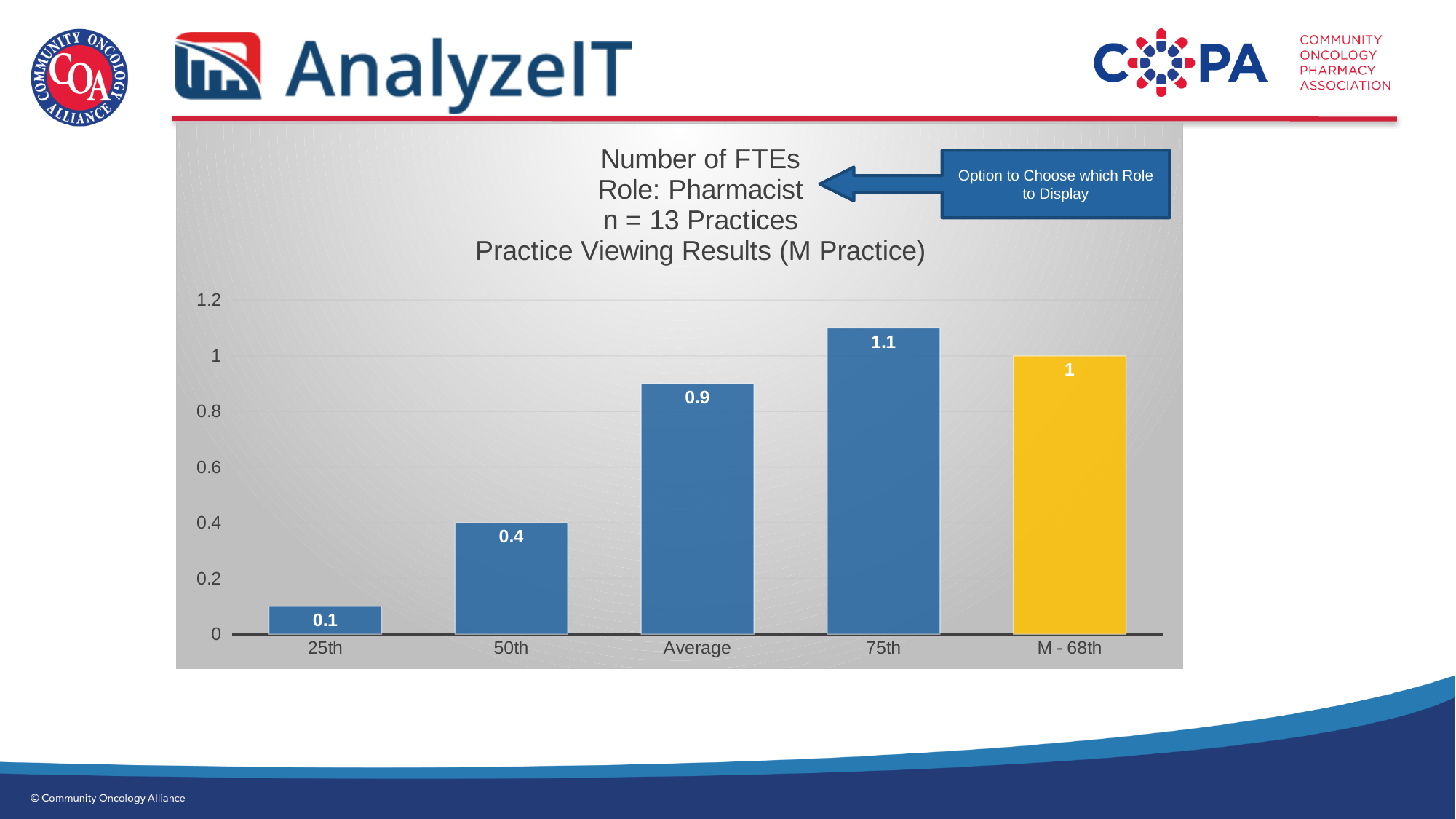
What is the value for Average? 0.9 What kind of chart is shown on the slide? Bar chart Which category has the highest value? 75th What is the value for the 25th category? 0.1 What is the difference between the values for 75th and 25th? 1 Which is larger, the value for Average or the value for M - 68th? M - 68th What is the value for the 75th category? 1.1 What is the value for M - 68th? 1 What is the value for the 50th category? 0.4 Which role is shown in the chart title? Pharmacist How many categories are shown on the x axis? 5 Which category has the lowest value? 25th